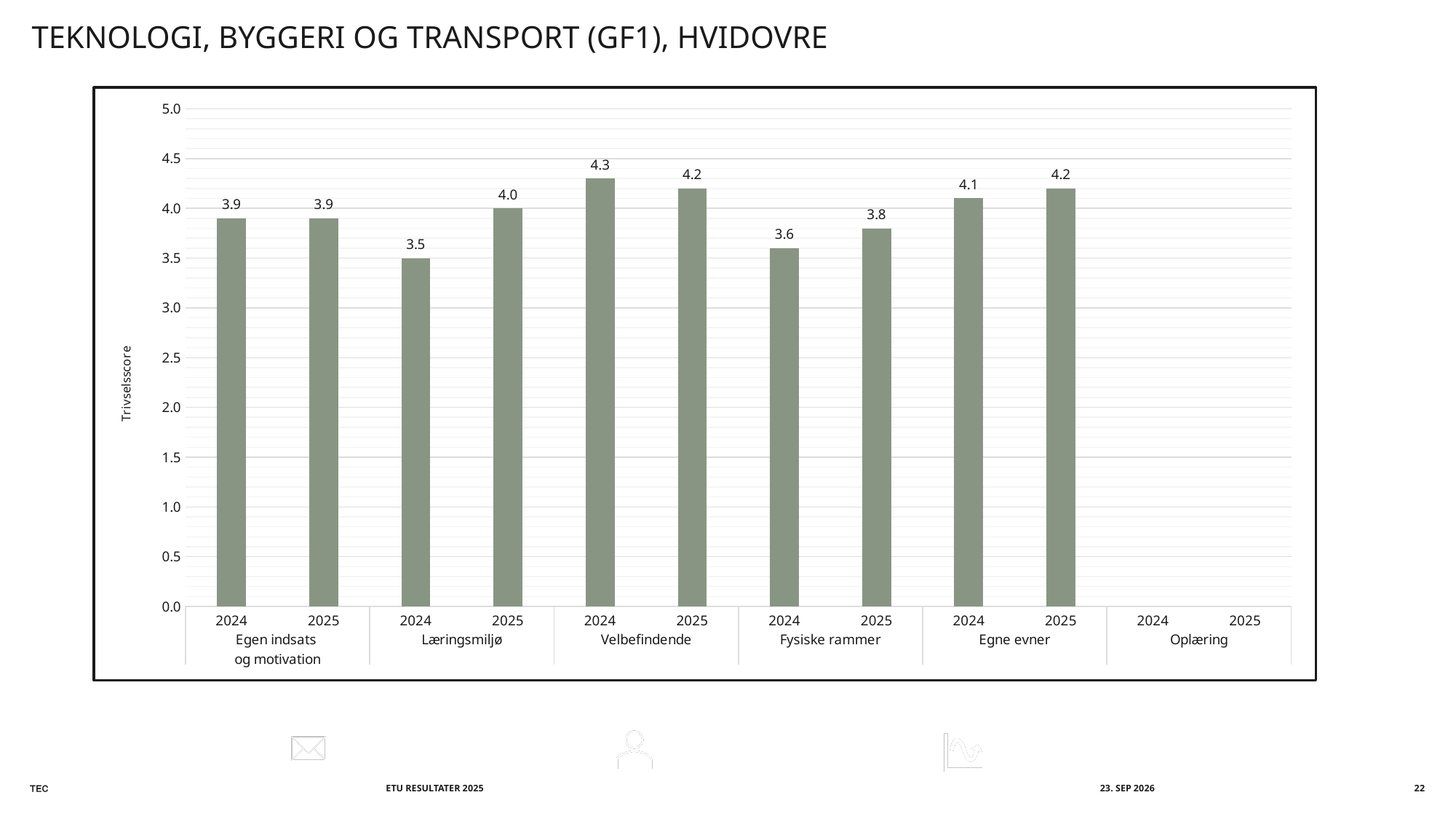
What is the Trivselsscore for Velbefindende in 2024? 4.3 Which bar has the lowest Trivselsscore on the chart? Læringsmiljø 2024 What is the Trivselsscore for Egne evner in 2024? 4.1 What is the Trivselsscore for Læringsmiljø in 2025? 4.0 Which category group on the x axis has no bars plotted? Oplæring Which bar has the highest Trivselsscore on the chart? Velbefindende 2024 What is the difference between the 2025 and 2024 Trivselsscore for Fysiske rammer? 0.2 Which is larger: the 2024 Trivselsscore for Velbefindende or the 2024 Trivselsscore for Fysiske rammer? Velbefindende 2024 What is the difference between the 2025 and 2024 Trivselsscore for Læringsmiljø? 0.5 What is the Trivselsscore for Fysiske rammer in 2025? 3.8 What kind of chart is shown on the slide? Bar chart Is the 2024 Trivselsscore for Læringsmiljø greater or less than 4.0? less